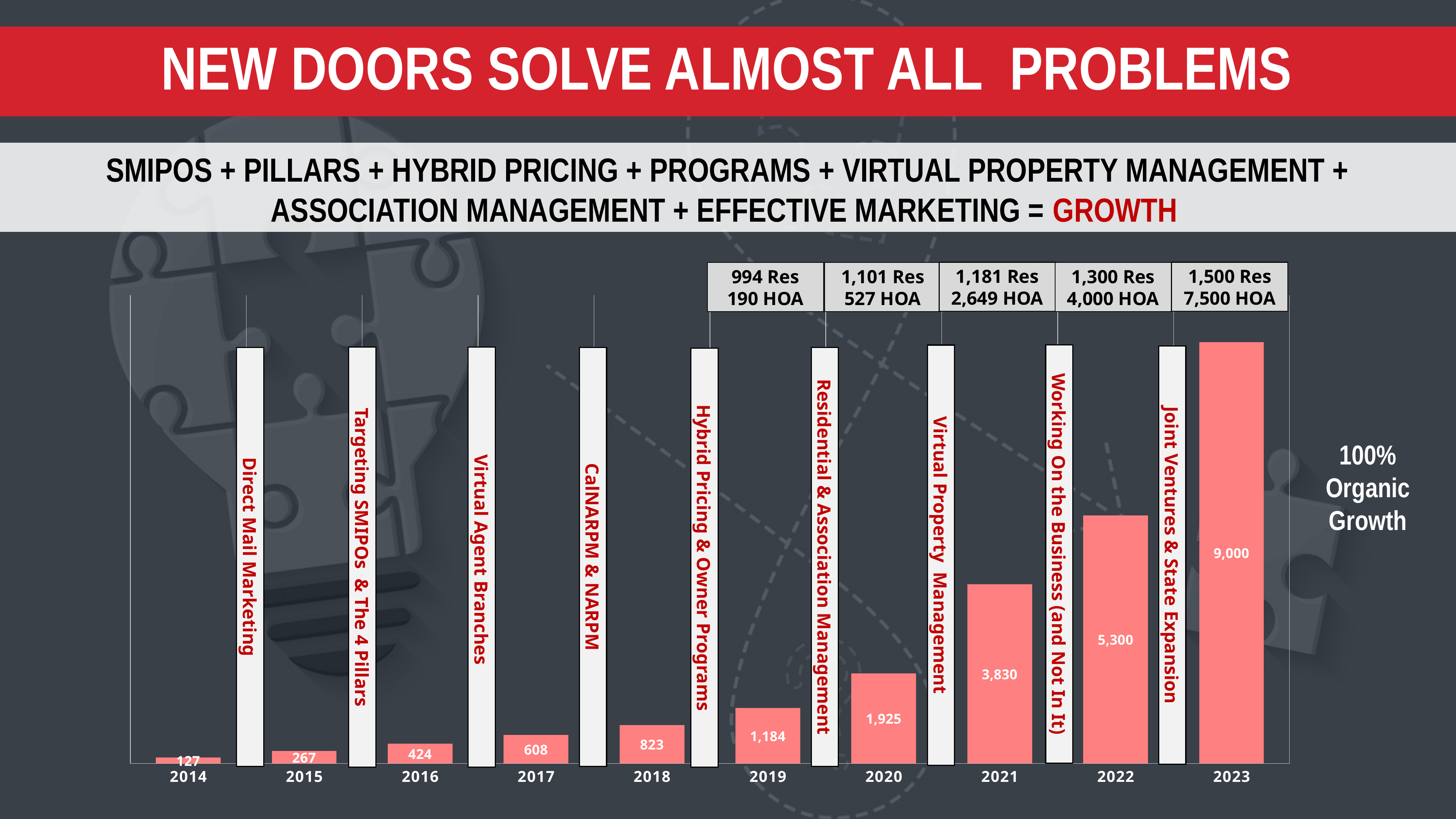
What is the difference between the values for 2023 and 2022? 3,700 Which year has the lowest value? 2014 What HOA count is shown in the annotation above the 2023 bar? 7,500 HOA Which year has the highest value? 2023 What is the difference between the values for 2021 and 2020? 1,905 What is the value shown for 2016? 424 What is the value shown for 2023? 9,000 What is the value shown for 2019? 1,184 How many years are shown on the x axis? 10 What kind of chart is shown on the slide? Bar chart Do the values rise or fall from 2014 to 2023? Rise Which is larger, the value for 2018 or the value for 2017? 2018